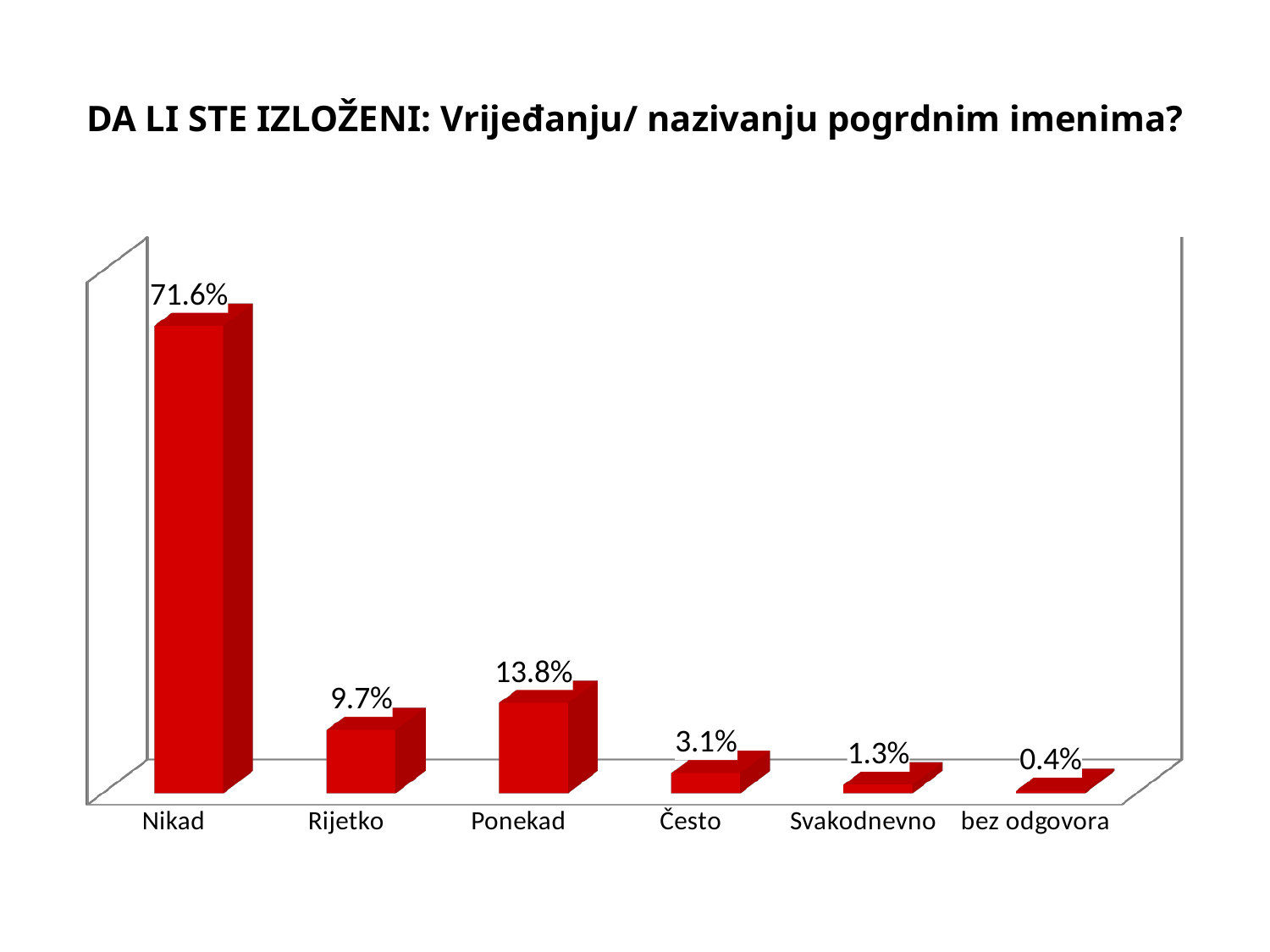
Which is larger, the value for Rijetko or the value for Ponekad? Ponekad What is the title of the chart? DA LI STE IZLOŽENI: Vrijeđanju/ nazivanju pogrdnim imenima? What is the value for bez odgovora? 0.4% What is the value for Ponekad? 13.8% What kind of chart is this? bar chart What is the value for Nikad? 71.6% How many categories are shown on the x axis? 6 Which category has the highest value? Nikad Which category has the lowest value? bez odgovora What is the difference between the values for Često and Svakodnevno? 1.8% What is the difference between the values for Ponekad and Rijetko? 4.1% What is the value for Svakodnevno? 1.3%